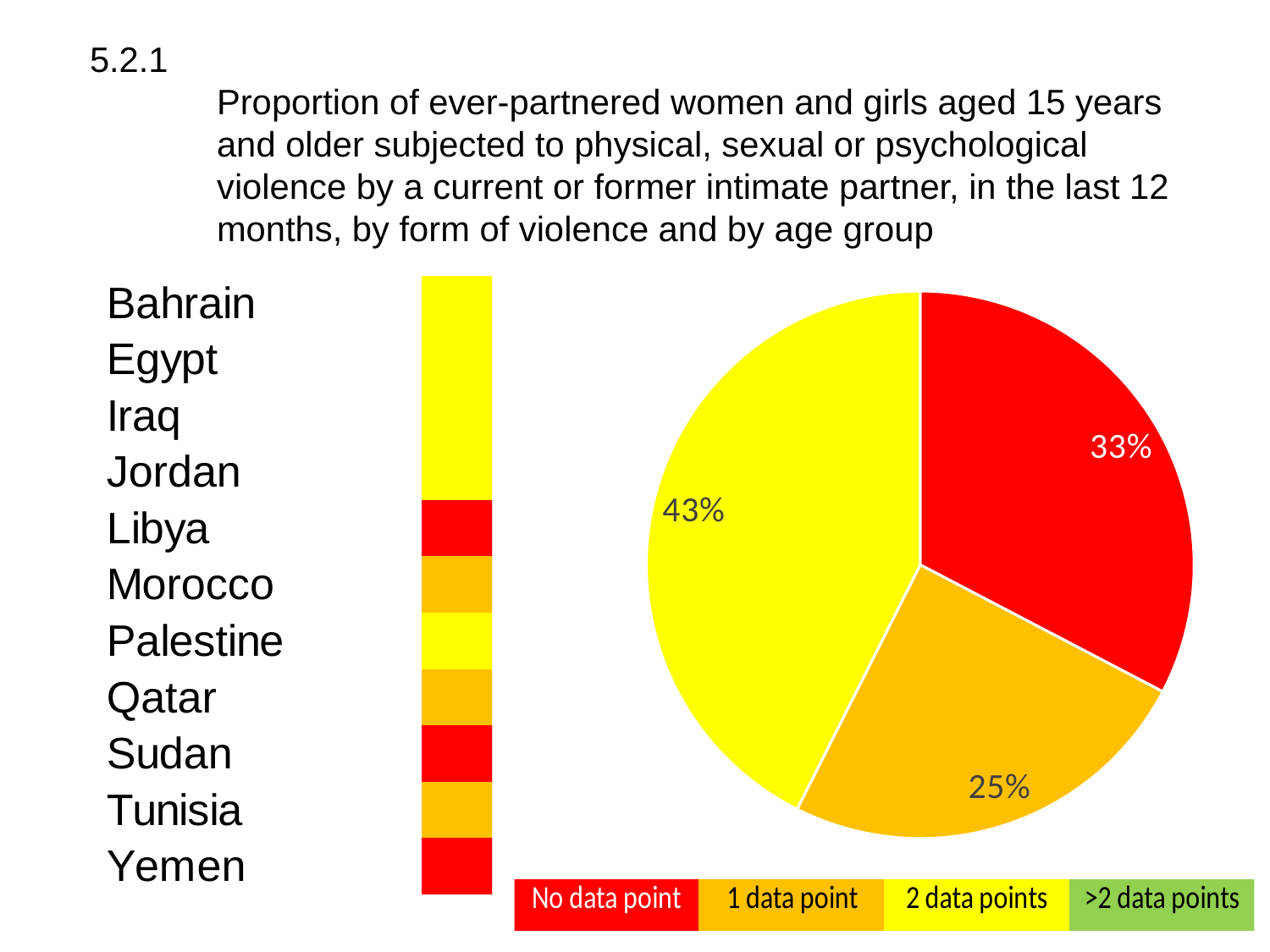
Which colour in the legend represents '>2 data points'? green Which category has the smallest slice in the pie chart? 1 data point In the pie chart, what share is shown for the red slice (No data point)? 33% According to the colour strip next to the country list, which data-availability category does Libya fall into? No data point How many entries does the legend at the bottom of the slide list? 4 In the pie chart, what share is shown for the yellow slice (2 data points)? 43% How many slices does the pie chart have? 3 In the pie chart, what share is shown for the orange slice (1 data point)? 25% Which category has the largest slice in the pie chart? 2 data points What is the difference between the yellow slice (43%) and the red slice (33%) in the pie chart? 10% What type of chart is shown on the right of the slide? pie chart In the pie chart, which slice is larger: No data point or 1 data point? No data point